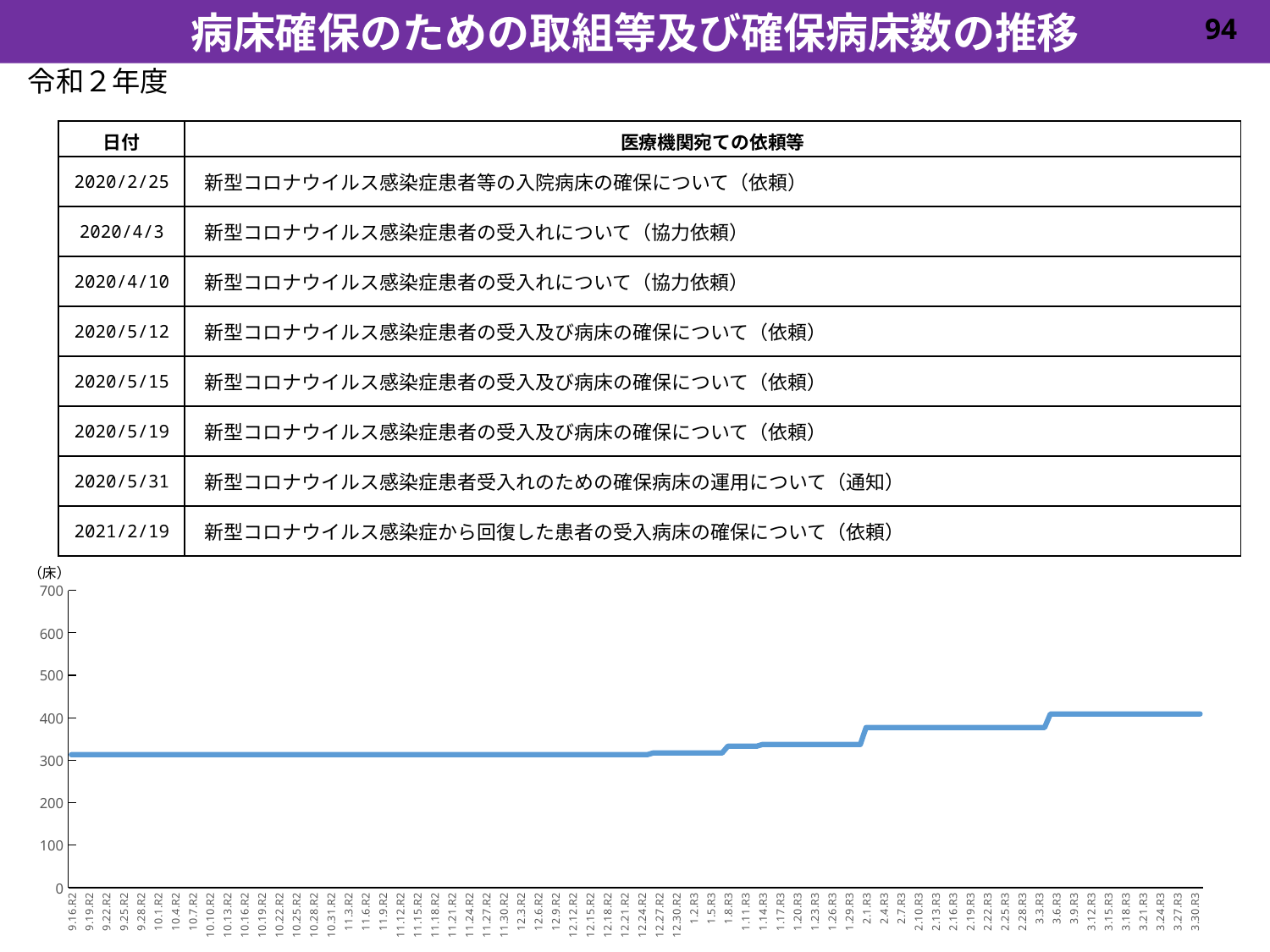
Is the value for 9.16.R2 greater or less than 300? greater Is the value for 9.16.R2 greater or less than 400? less Is the value for 2.4.R3 greater or less than 300? greater Do the values in the line chart rise or fall from left to right along the x axis? rise Which is larger, the value for 12.6.R2 or the value for 2.10.R3? 2.10.R3 What unit label is shown at the top of the y axis of the chart? (床) What kind of chart is shown at the bottom of the slide? line chart How many lines (series) are plotted in the chart? 1 Which is larger, the value for 9.16.R2 or the value for 3.30.R3? 3.30.R3